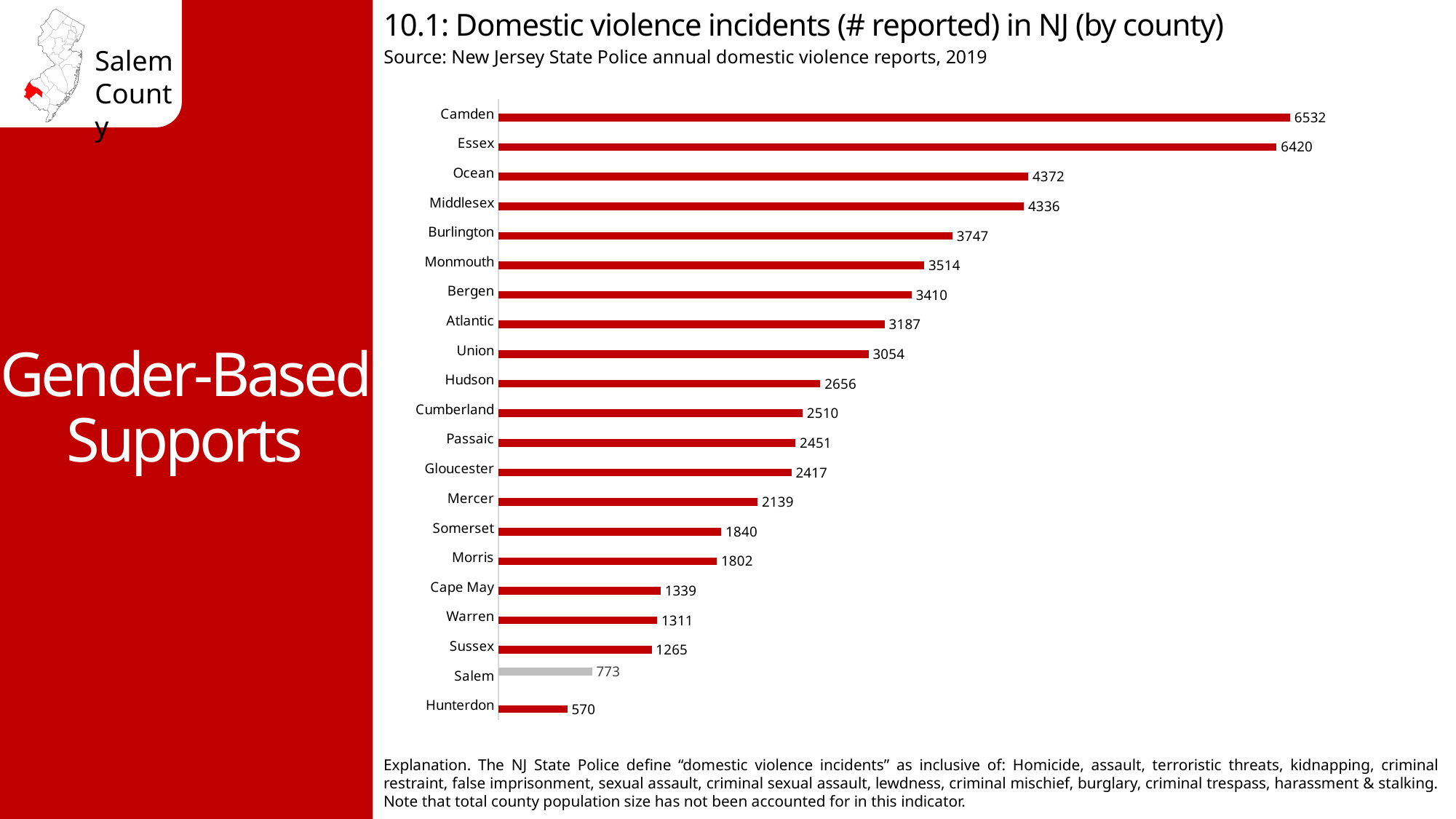
What is the difference between the values for Camden and Essex? 112 How many counties are shown in the chart? 21 Which county has more reported incidents, Cape May or Sussex? Cape May What type of chart is used on this slide? Bar chart What is the difference between the values for Salem and Hunterdon? 203 What is the value shown for Camden? 6532 How many incidents are shown for Gloucester? 2417 How many domestic violence incidents were reported in Salem County? 773 Which county's bar is shown in a different colour (grey) from the others? Salem Which county has the highest number of reported domestic violence incidents? Camden Which county has more reported incidents, Ocean or Burlington? Ocean Which county has the lowest number of reported domestic violence incidents? Hunterdon